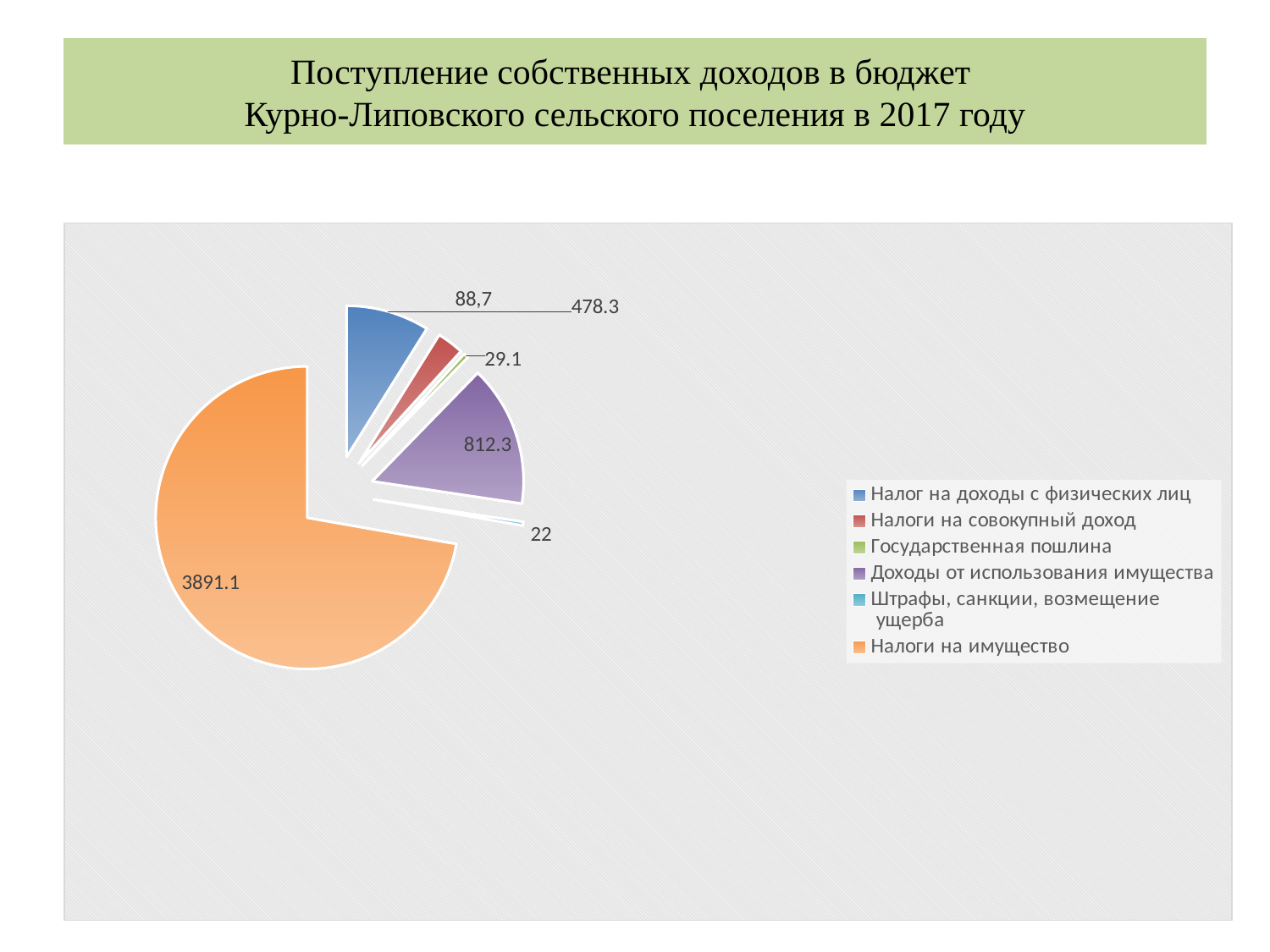
What is the value for Государственная пошлина? 29.1 Which is larger: Доходы от использования имущества or Государственная пошлина? Доходы от использования имущества What kind of chart is shown on the slide? pie chart How many categories does the legend list? 6 What is the value for Налоги на имущество? 3891.1 What colour is the slice for Налоги на имущество? orange What is the value for Доходы от использования имущества? 812.3 What is the difference between the values for Налоги на имущество and Доходы от использования имущества? 3078.8 Which category has the smallest slice of the pie? Штрафы, санкции, возмещение ущерба Which category has the largest slice of the pie? Налоги на имущество What is the value for Штрафы, санкции, возмещение ущерба? 22 What is the difference between the values for Доходы от использования имущества and Государственная пошлина? 783.2